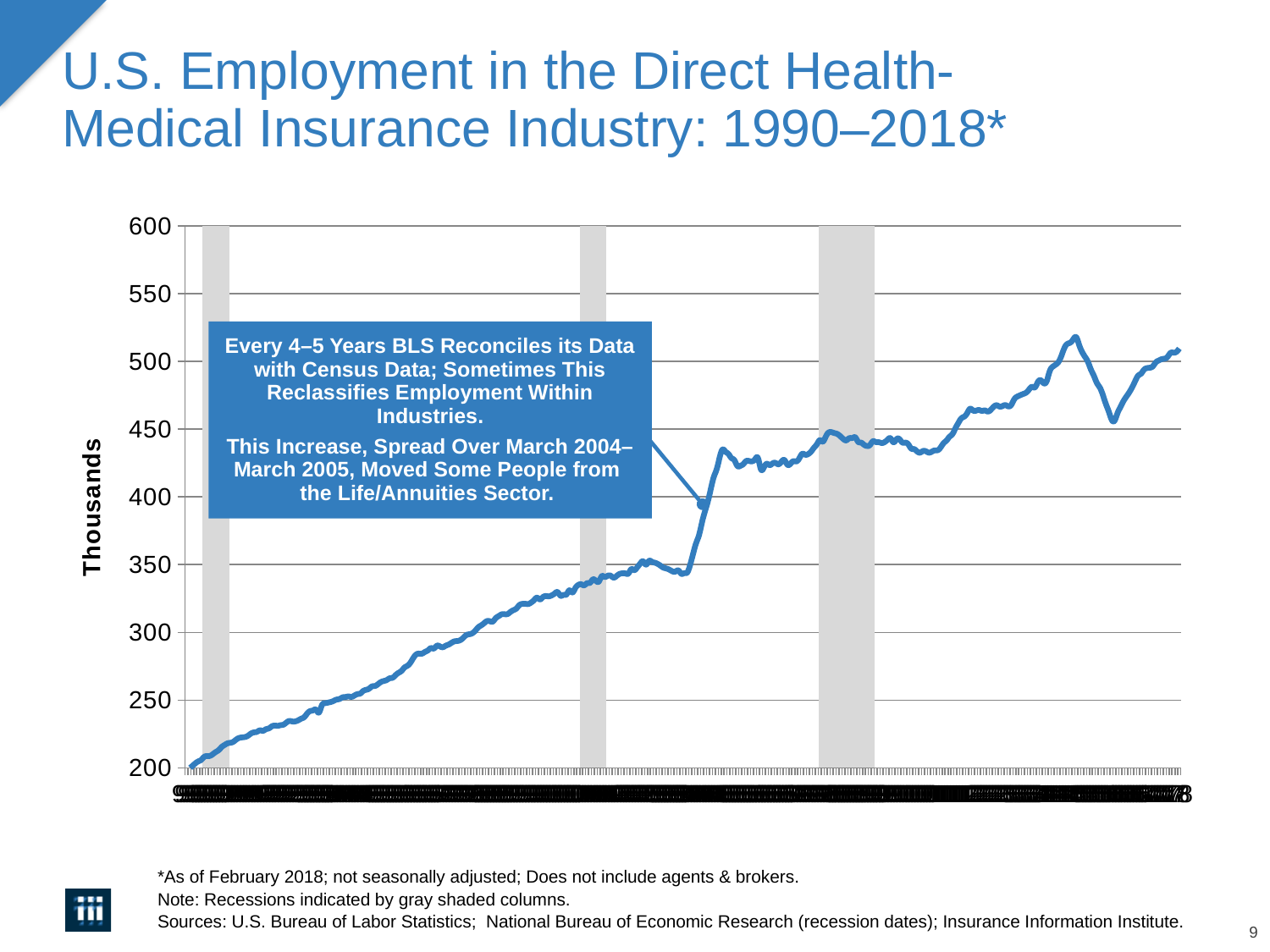
Is the highest point on the line greater or less than 550? less Is the lowest point on the line greater or less than 250? less Is the value at the end of the series (February 2018) greater or less than 500? greater What kind of chart is shown on the slide? line chart Which is larger, the value at the start of the series or the value at the end of the series? the value at the end of the series What is the label on the vertical axis? Thousands How many gray shaded recession columns appear on the chart? 3 Overall, do the values rise or fall from the start of the series in 1990 to the end in 2018? rise